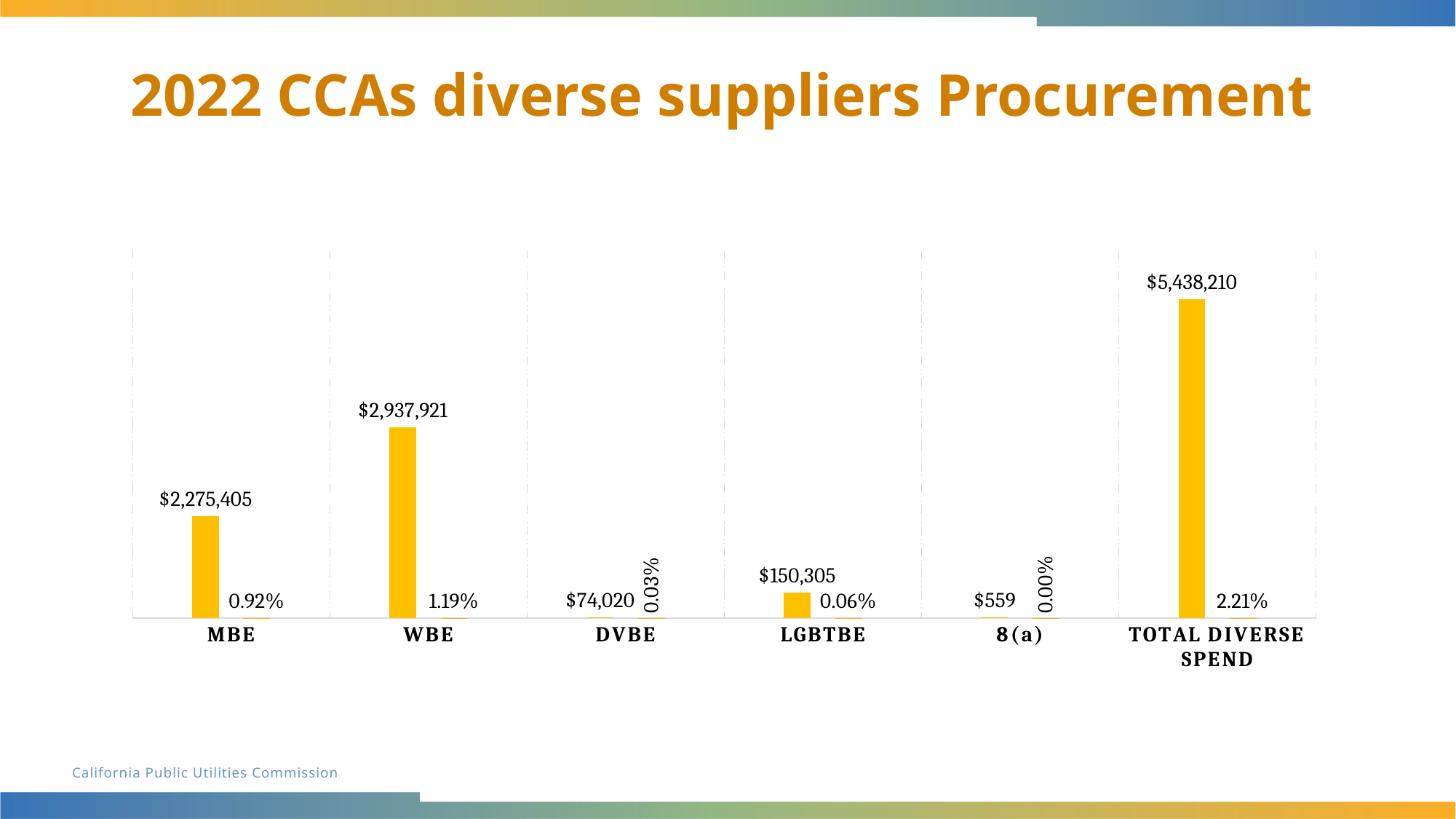
What percentage is shown for LGBTBE? 0.06% Which category has the highest dollar value? TOTAL DIVERSE SPEND Which category has the lowest dollar value? 8(a) What percentage is shown for TOTAL DIVERSE SPEND? 2.21% What is the difference in dollar value between LGBTBE and DVBE? $76,285 What is the dollar value shown for 8(a)? $559 What is the dollar value shown for WBE? $2,937,921 What is the dollar value shown for MBE? $2,275,405 What is the difference in dollar value between WBE and MBE? $662,516 Which has a larger dollar value, DVBE or LGBTBE? LGBTBE How many categories are shown on the x axis? 6 What kind of chart is shown on the slide? Bar chart